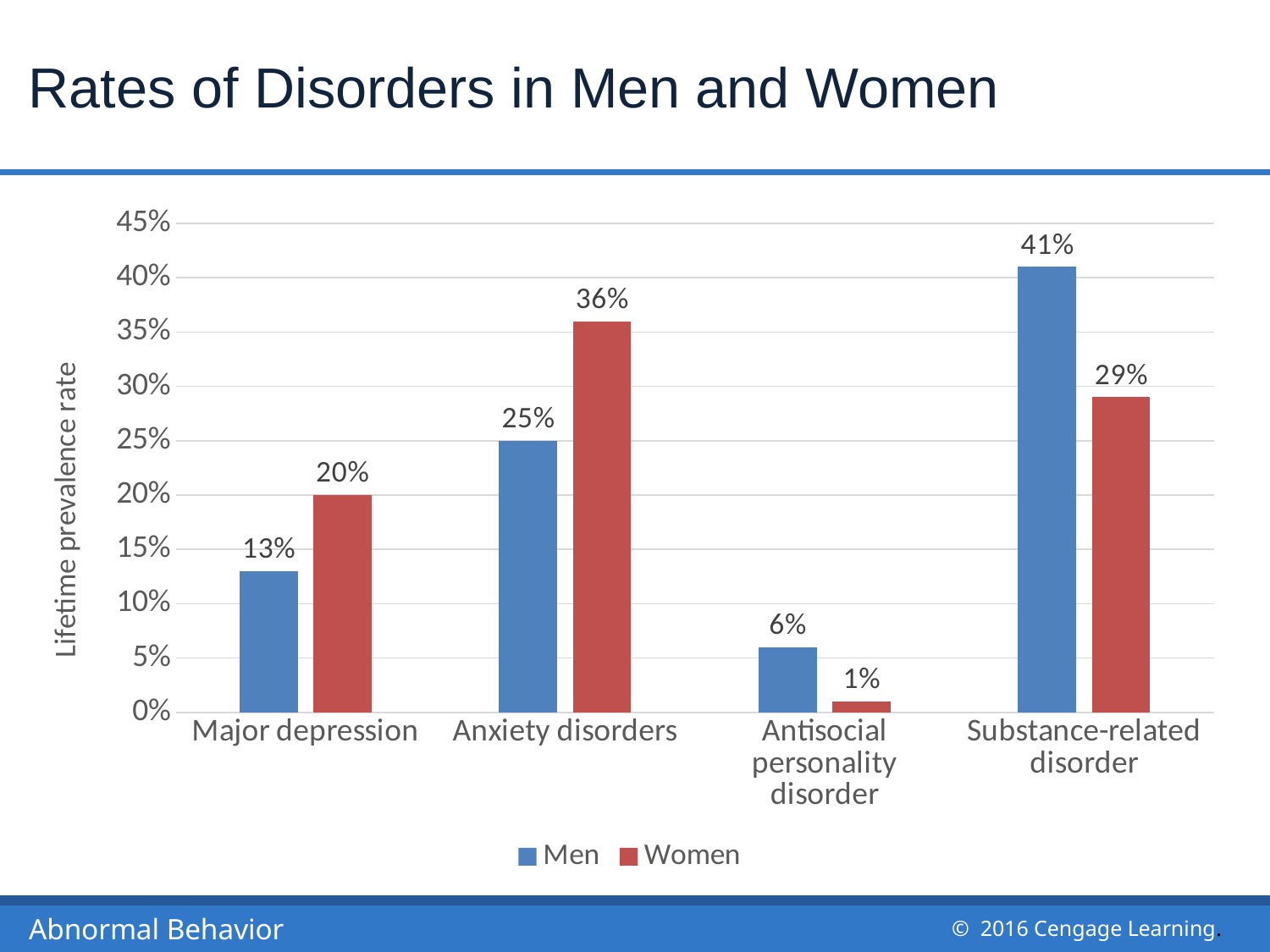
Which disorder has the lowest lifetime prevalence rate for women? Antisocial personality disorder What is the difference between the rates for women and men for anxiety disorders? 11% How many series does the legend list? 2 What is the difference between the rates for men and women for substance-related disorder? 12% Which disorder has the highest lifetime prevalence rate for men? Substance-related disorder What is the lifetime prevalence rate of anxiety disorders for men? 25% What kind of chart is shown on the slide? Bar chart For major depression, which group has the higher lifetime prevalence rate, men or women? Women How many disorder categories are shown on the x axis? 4 What is the lifetime prevalence rate of antisocial personality disorder for women? 1% What is the lifetime prevalence rate of major depression for women? 20% What is the label of the y axis? Lifetime prevalence rate